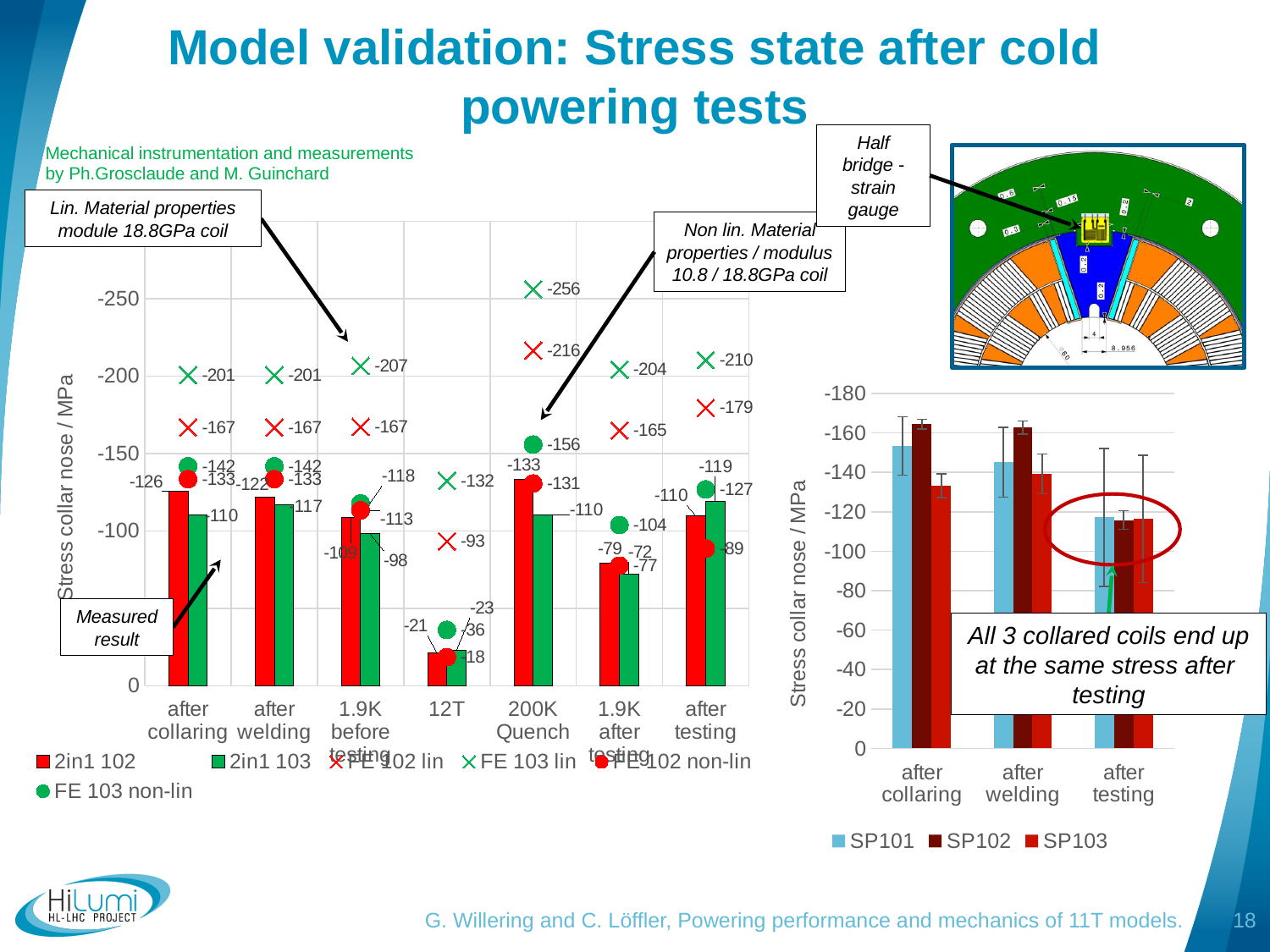
In the left chart, what is the value of FE 103 non-lin after testing? -127 How many series does the legend of the left chart list? 6 In the left chart, which is more negative at 200K Quench: 2in1 102 or 2in1 103? 2in1 102 In the left chart, what is the value of FE 103 lin at 200K Quench? -256 In the left chart, what is the difference between the FE 103 lin and FE 102 lin values after collaring? 34 In the left chart, what is the value of 2in1 102 after collaring? -126 How many categories are shown on the x axis of the left chart? 7 What kind of chart is the right chart? bar chart In the left chart, what is the value of FE 102 lin at 1.9K after testing? -165 In the right chart, is the value for SP102 after collaring more negative or less negative than -160? more negative How many series does the legend of the right chart list? 3 In the left chart, at which category does FE 103 lin reach its most negative value? 200K Quench